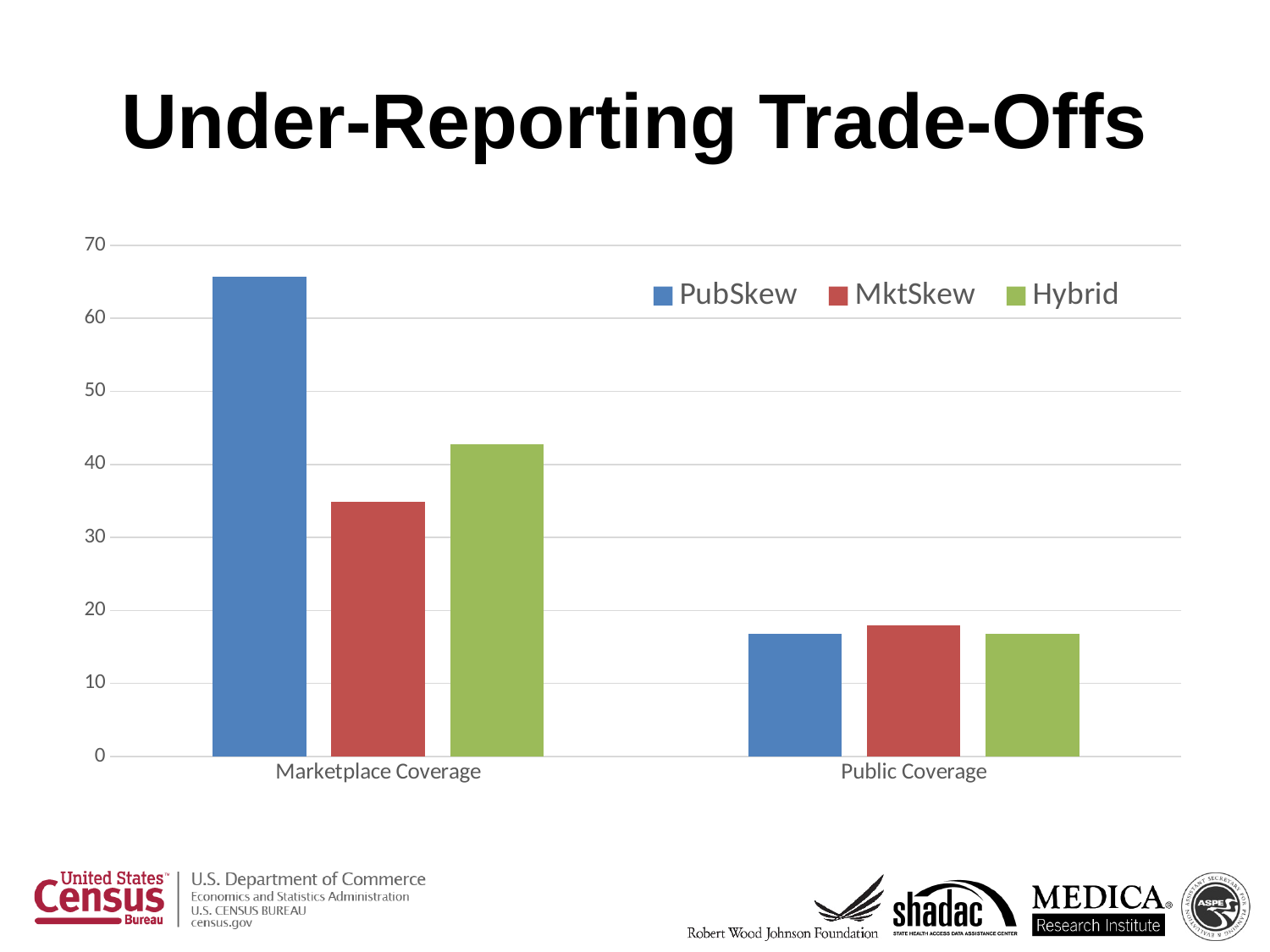
What is the title of the slide containing the chart? Under-Reporting Trade-Offs Which colour represents the Hybrid series in the chart? green Is the MktSkew value for Public Coverage greater or less than 20? less How many categories are shown on the x axis? 2 Which is larger: the PubSkew value for Marketplace Coverage or the PubSkew value for Public Coverage? Marketplace Coverage Is the PubSkew value for Marketplace Coverage greater or less than 60? greater Is the Hybrid value for Marketplace Coverage greater or less than 40? greater How many series does the legend list? 3 What kind of chart is shown on the slide? bar chart Which series has the lowest value for Marketplace Coverage? MktSkew Which series has the highest value for Marketplace Coverage? PubSkew